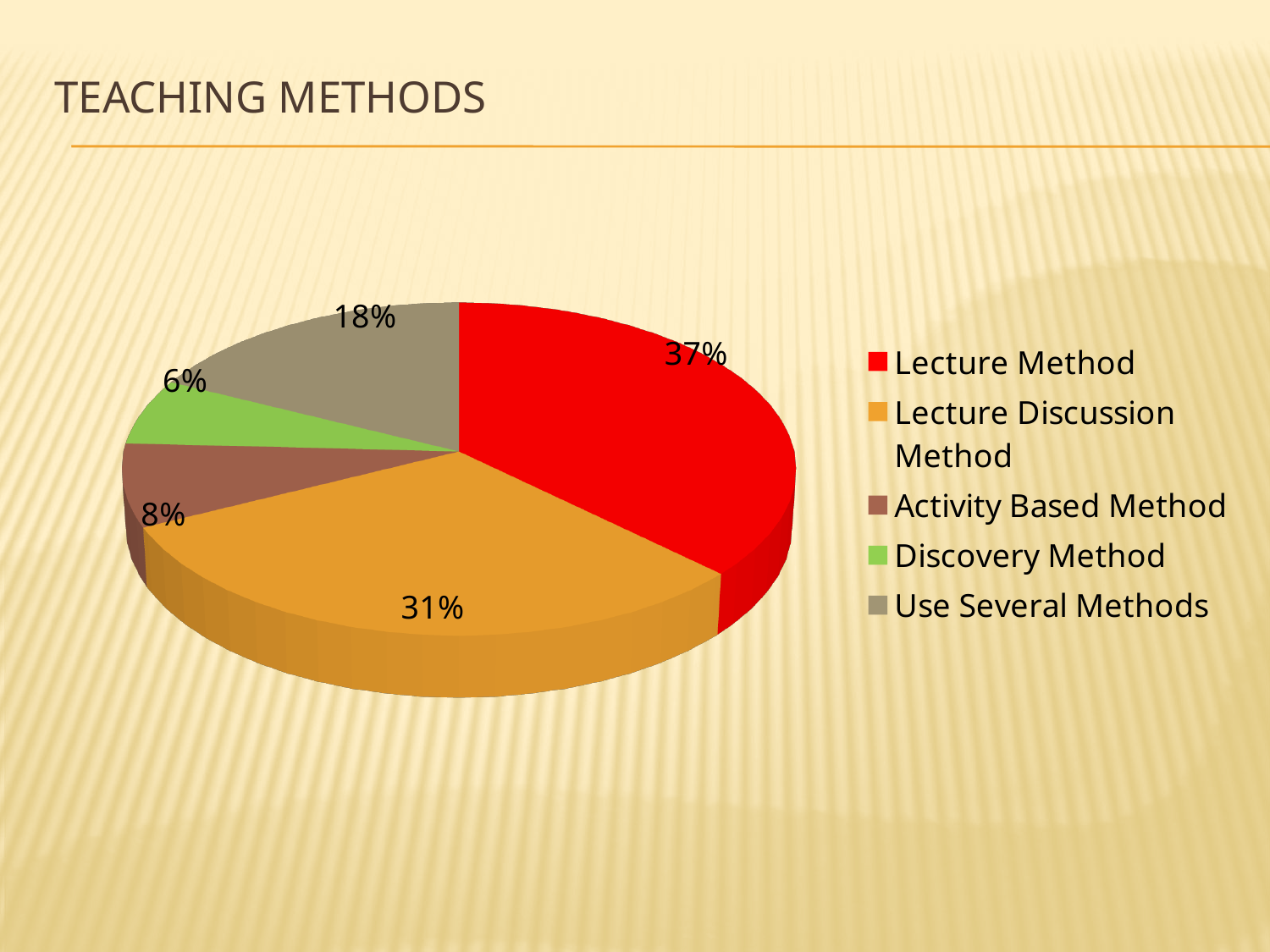
What is the difference between the shares for Lecture Method and Lecture Discussion Method? 6% What share of the pie does Lecture Method have? 37% Which colour represents Discovery Method in the legend? green What share of the pie does Use Several Methods have? 18% What kind of chart is shown on the slide? pie chart Which teaching method has the smallest share of the pie? Discovery Method What share of the pie does Activity Based Method have? 8% How many slices does the pie chart have? 5 Which teaching method has the largest share of the pie? Lecture Method Which is larger, the share for Use Several Methods or the share for Activity Based Method? Use Several Methods